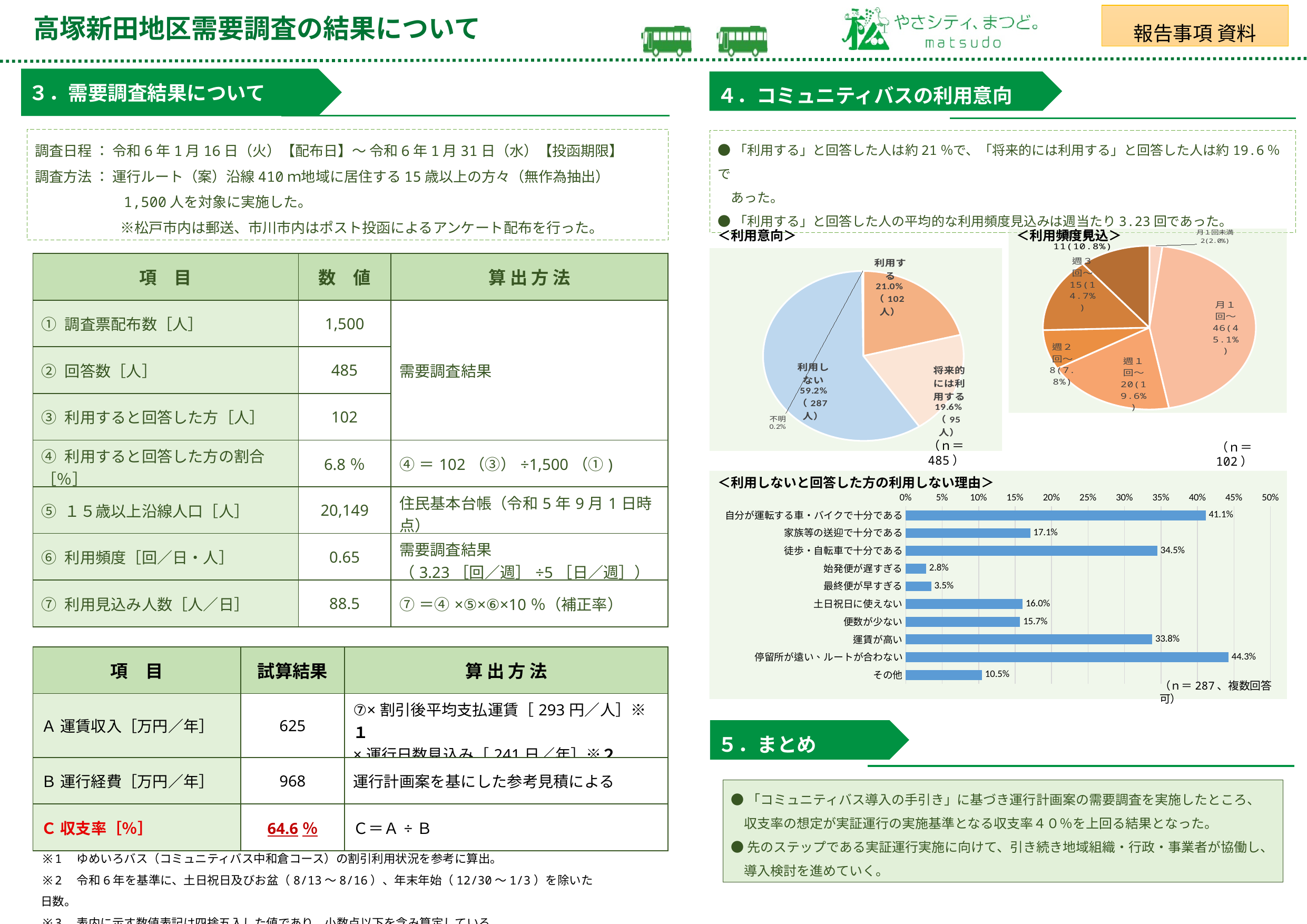
In the ＜利用頻度見込＞ pie chart, what is the value for 月1回～? 46(45.1%) In the ＜利用しないと回答した方の利用しない理由＞ bar chart, what is the value for 停留所が遠い、ルートが合わない? 44.3% In the ＜利用しないと回答した方の利用しない理由＞ bar chart, which is larger: 土日祝日に使えない or 便数が少ない? 土日祝日に使えない In the ＜利用しないと回答した方の利用しない理由＞ bar chart, what is the difference between 自分が運転する車・バイクで十分である and 徒歩・自転車で十分である? 6.6% In the ＜利用意向＞ pie chart, how many people answered 将来的には利用する? 95人 In the ＜利用しないと回答した方の利用しない理由＞ bar chart, which reason has the highest value? 停留所が遠い、ルートが合わない In the ＜利用頻度見込＞ pie chart, which is larger: 週1回～ or 週2回～? 週1回～ In the ＜利用しないと回答した方の利用しない理由＞ bar chart, which reason has the lowest value? 始発便が遅すぎる What type of chart is the ＜利用しないと回答した方の利用しない理由＞ chart? bar chart How many reasons (categories) are shown in the ＜利用しないと回答した方の利用しない理由＞ bar chart? 10 In the ＜利用意向＞ pie chart, which response has the largest share? 利用しない In the ＜利用意向＞ pie chart, what percentage of respondents answered 利用しない? 59.2%